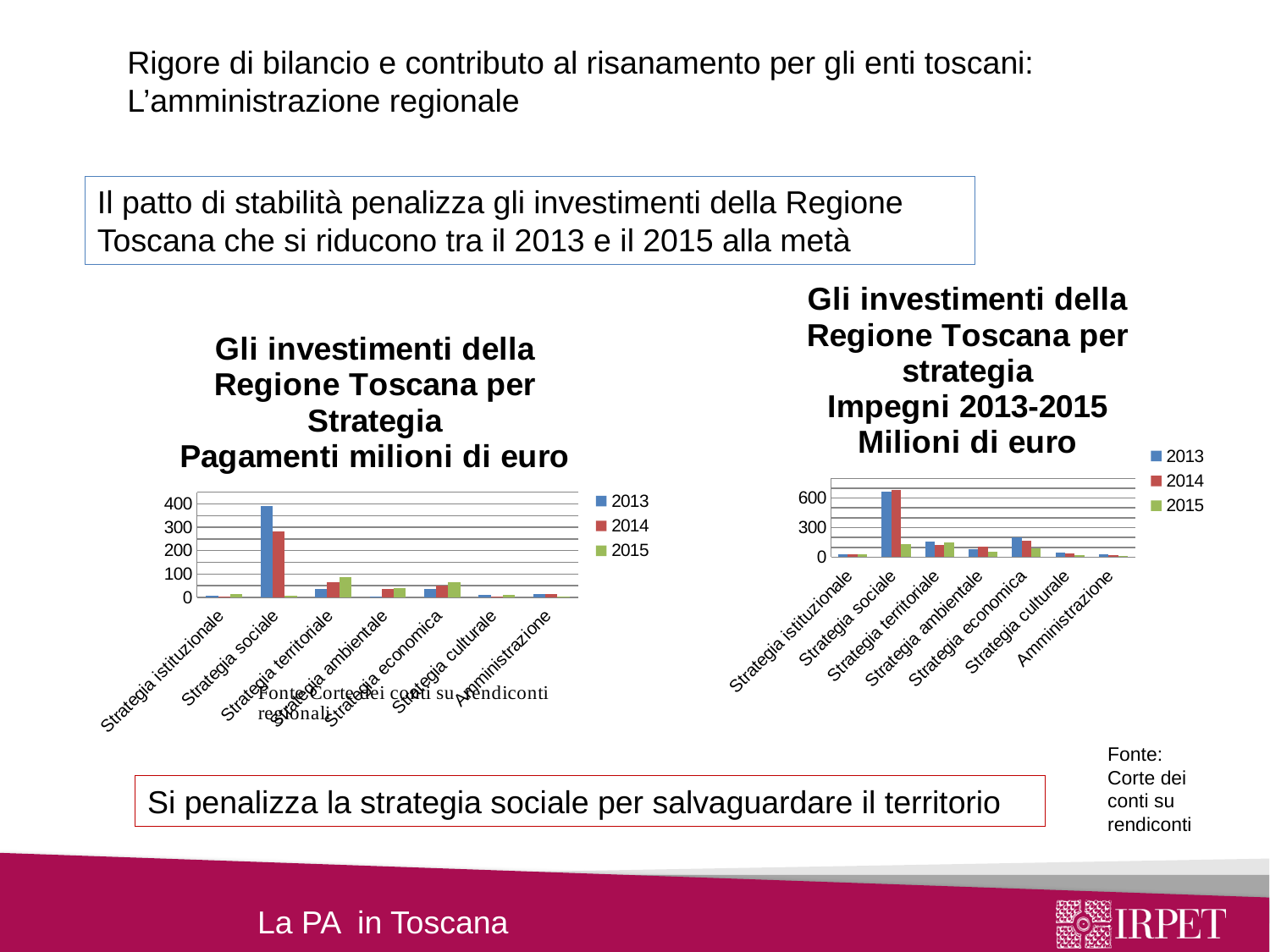
In the right chart, 'Impegni 2013-2015', which is larger for 2013: Strategia sociale or Strategia economica? Strategia sociale In the right chart, 'Impegni 2013-2015', which colour represents the 2015 series? Green How many categories are shown on the x axis of the left chart, 'Pagamenti milioni di euro'? 7 In the left chart, 'Pagamenti milioni di euro', do the values for Strategia sociale rise or fall from 2013 to 2015? fall In the left chart, 'Pagamenti milioni di euro', is the 2013 value for Strategia sociale greater or less than 300? greater In the left chart, 'Pagamenti milioni di euro', which category has the highest value for 2013? Strategia sociale In the right chart, 'Impegni 2013-2015', is the 2015 value for Strategia sociale greater or less than 300? less How many series does the legend of the right chart, 'Impegni 2013-2015', list? 3 In the right chart, 'Impegni 2013-2015', which category has the highest value for 2014? Strategia sociale What kind of chart is the left chart, 'Gli investimenti della Regione Toscana per Strategia Pagamenti milioni di euro'? Bar chart In the right chart, 'Impegni 2013-2015', is the 2013 value for Strategia sociale greater or less than 600? greater